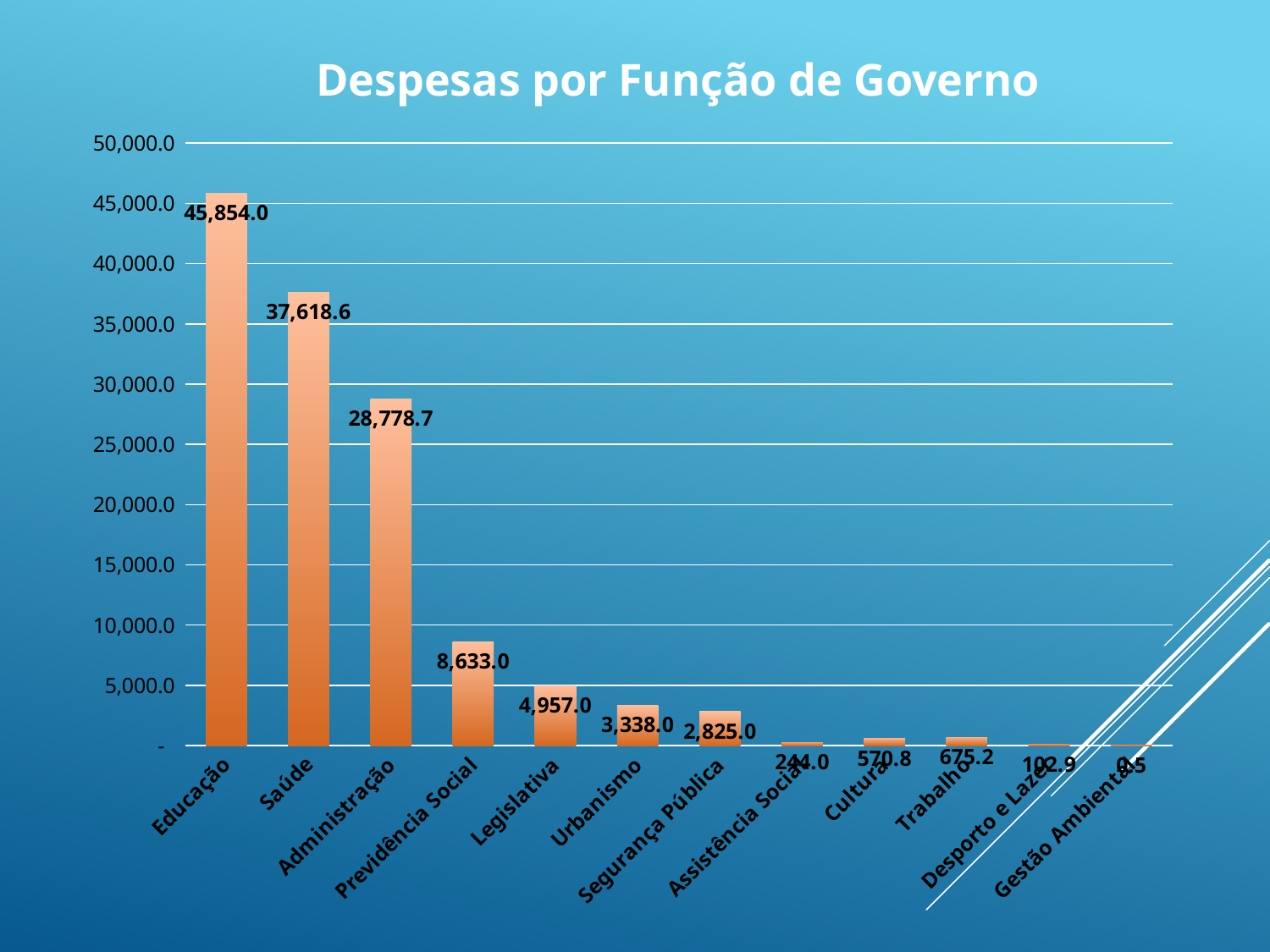
What is the difference between the values for Educação and Saúde? 8,235.4 How many categories are shown on the x axis? 12 What is the value for Educação? 45,854.0 Which is larger, the value for Cultura or the value for Trabalho? Trabalho What kind of chart is shown on the slide? Bar chart What is the difference between the values for Urbanismo and Segurança Pública? 513.0 What is the value for Saúde? 37,618.6 What is the value for Previdência Social? 8,633.0 Which category has the lowest value? Gestão Ambiental What is the value for Administração? 28,778.7 Which category has the highest value? Educação What is the value for Trabalho? 675.2